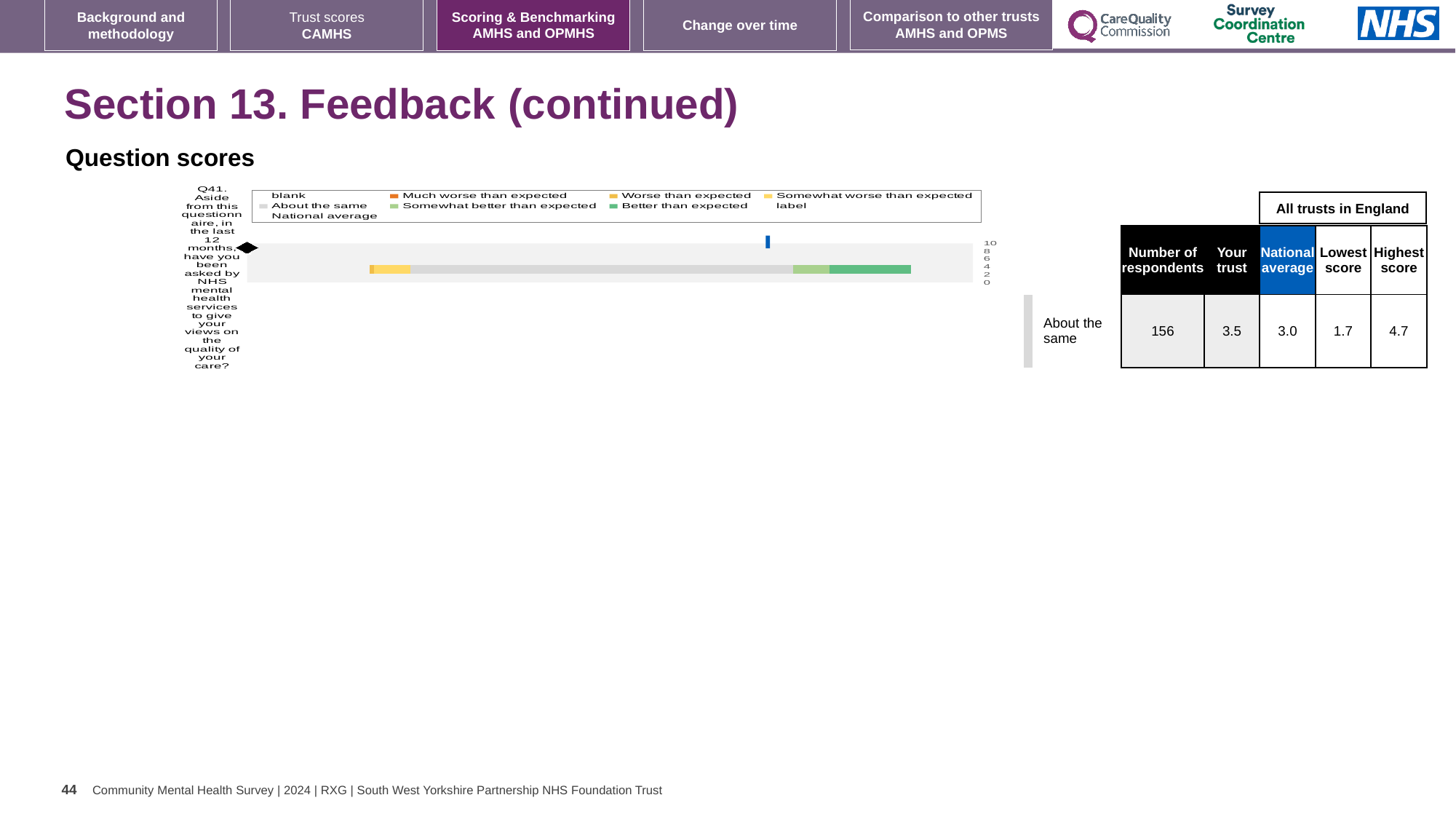
What is the highest value shown on the chart's axis? 10 What is the difference between the 'Your trust' score and the national average for Q41? 0.5 What is the number of respondents for Q41? 156 What is the highest score among all trusts in England for Q41? 4.7 What is the national average score for Q41? 3.0 How many survey questions are plotted in the chart? 1 Which is larger for Q41, the 'Your trust' score or the national average? Your trust What is the 'Your trust' score for Q41? 3.5 What kind of chart is shown on the slide? bar chart What is the lowest score among all trusts in England for Q41? 1.7 Which question number is plotted in the chart? Q41 What is the difference between the highest score and the lowest score for Q41? 3.0